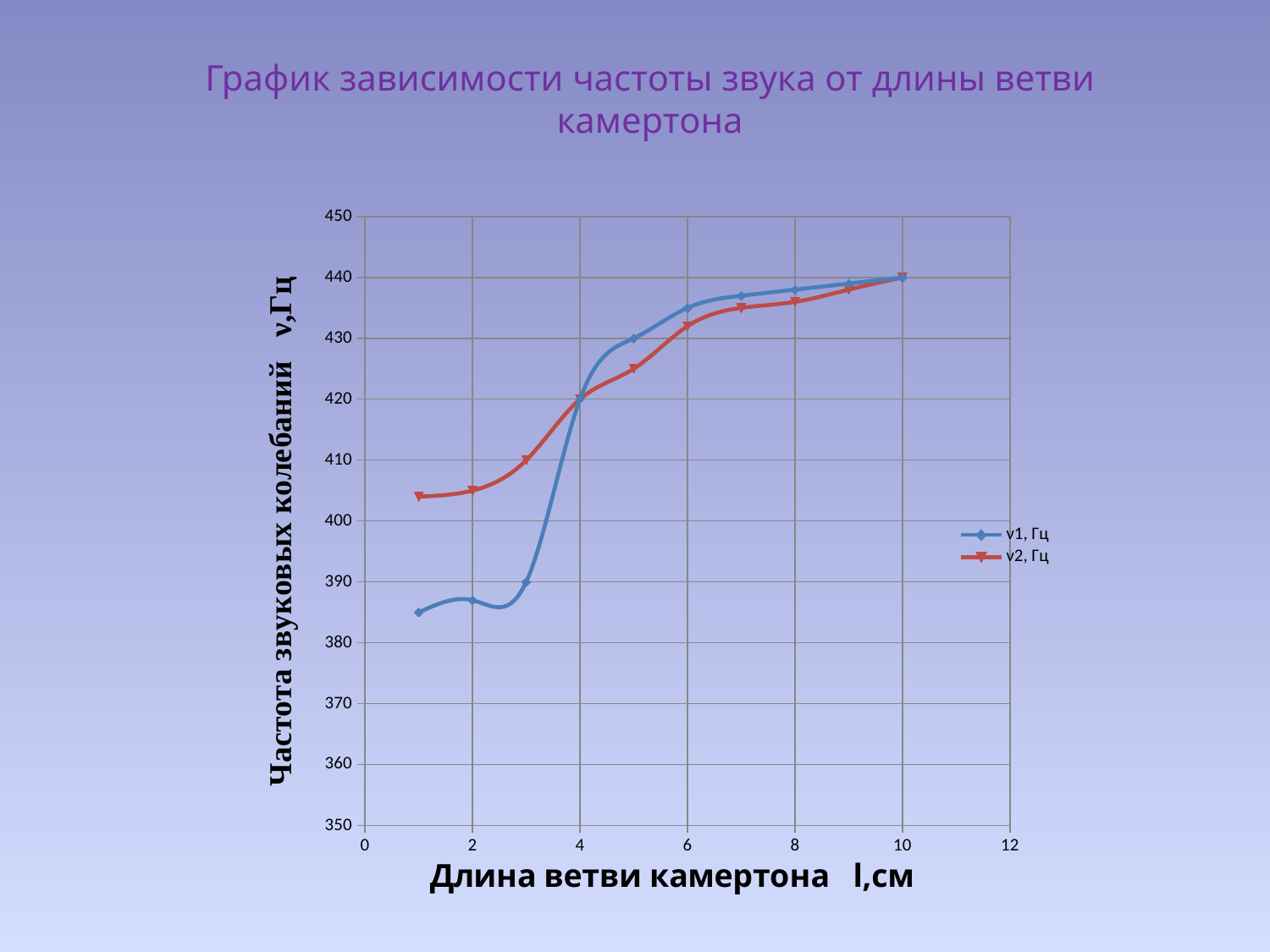
What is the value of v2, Гц at a branch length of 3 cm? 410 What is the value of v2, Гц at a branch length of 10 cm? 440 What is the value of v1, Гц at a branch length of 5 cm? 430 Is the value of v2, Гц at a branch length of 1 cm greater or less than 400? greater Is the value of v1, Гц at a branch length of 1 cm greater or less than 390? less What is the value of v1, Гц at a branch length of 3 cm? 390 What kind of chart is shown on the slide? line chart How many series does the legend list? 2 At a branch length of 1 cm, which series has the larger value, v1, Гц or v2, Гц? v2, Гц At which branch length does the v1, Гц series reach its lowest value? 1 How many data points does the v1, Гц series have? 10 Do the values of the v1, Гц series rise or fall as the branch length increases along the x axis? rise